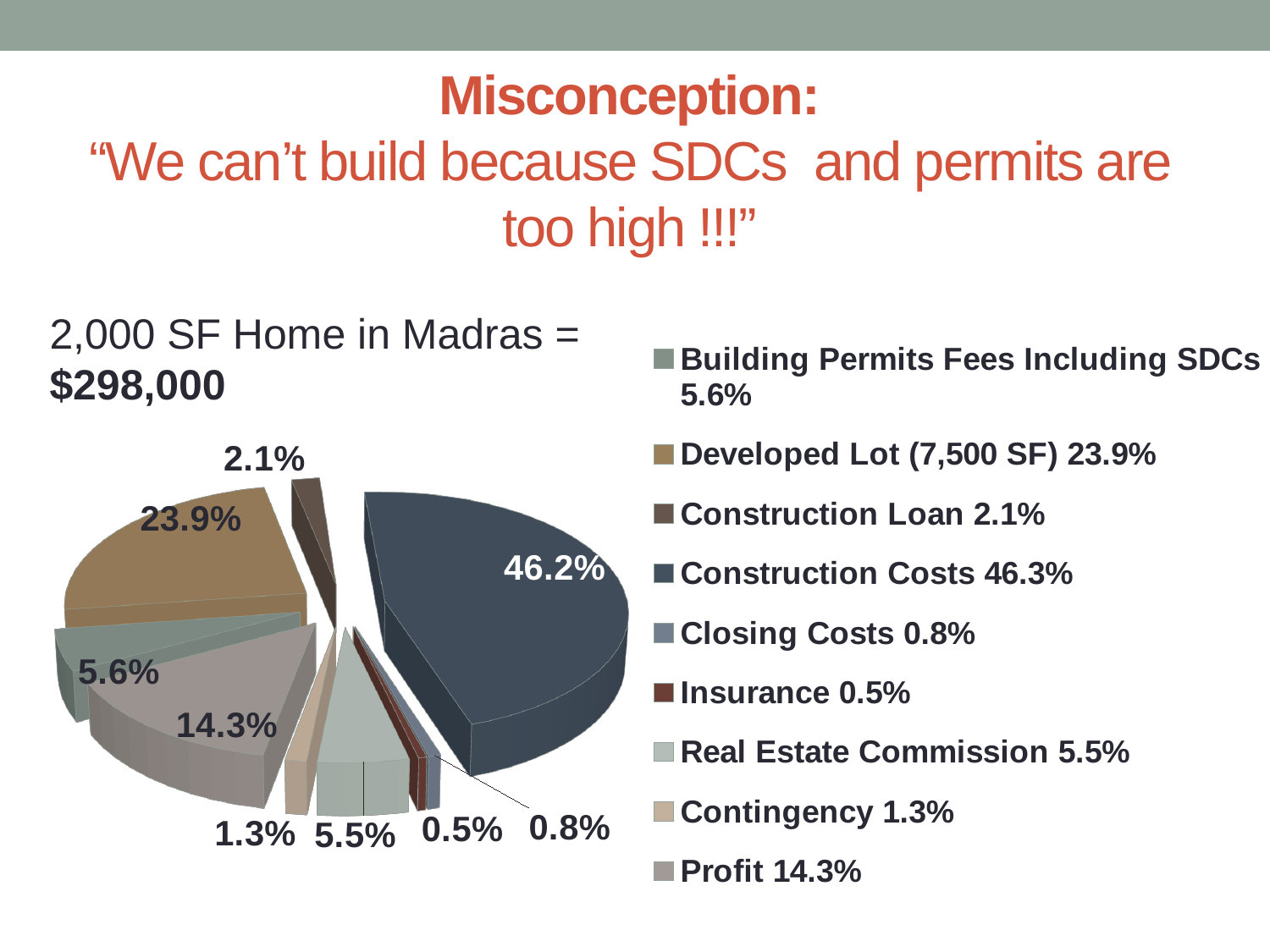
How many slices does the pie chart have? 9 What share of the pie is Closing Costs? 0.8% What share of the pie is Contingency? 1.3% Which category has the smallest slice of the pie? Insurance What kind of chart is shown on the slide? pie chart What share of the pie is Profit? 14.3% What total home cost does the slide state for a 2,000 SF home in Madras? $298,000 What is the difference between the Developed Lot share and the Profit share? 9.6% What share of the pie is Building Permits Fees Including SDCs? 5.6% Which is larger, the Profit slice or the Building Permits Fees Including SDCs slice? Profit What share of the pie is Developed Lot (7,500 SF)? 23.9% Which category has the largest slice of the pie? Construction Costs